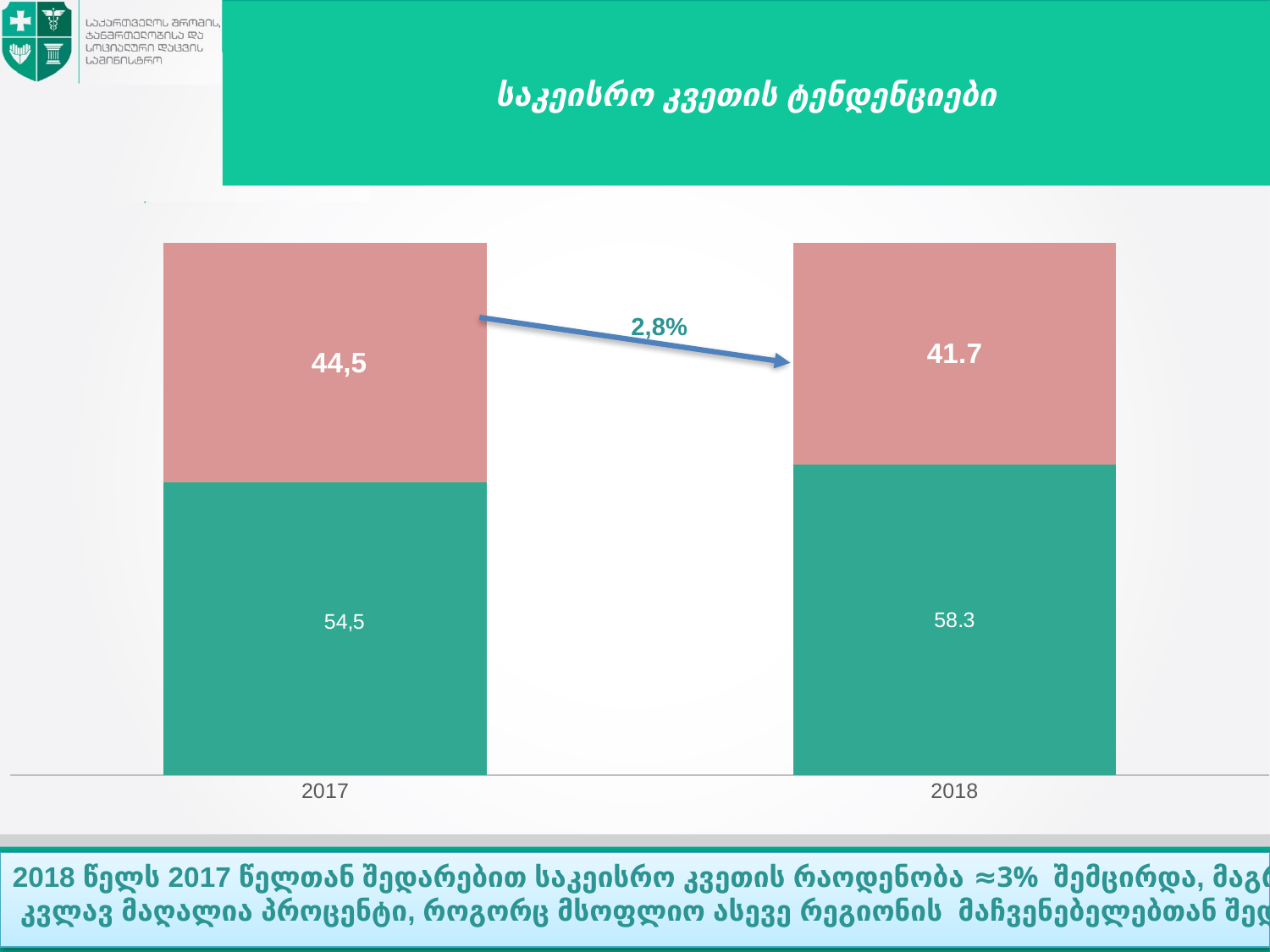
What is the difference between the green (bottom) segment values for 2018 and 2017? 3.8 How many years (categories) are shown on the x axis? 2 What is the value of the green (bottom) segment for 2017? 54,5 Which year has the larger green (bottom) segment, 2017 or 2018? 2018 What is the value of the green (bottom) segment for 2018? 58.3 What kind of chart is shown on the slide? Stacked bar chart What percentage is written on the arrow between the two bars? 2,8% Which year has the larger pink (top) segment, 2017 or 2018? 2017 By how much does the pink (top) segment decrease from 2017 to 2018? 2.8 What is the value of the pink (top) segment for 2017? 44,5 What is the value of the pink (top) segment for 2018? 41.7 What is the total of the stacked bar for 2018? 100